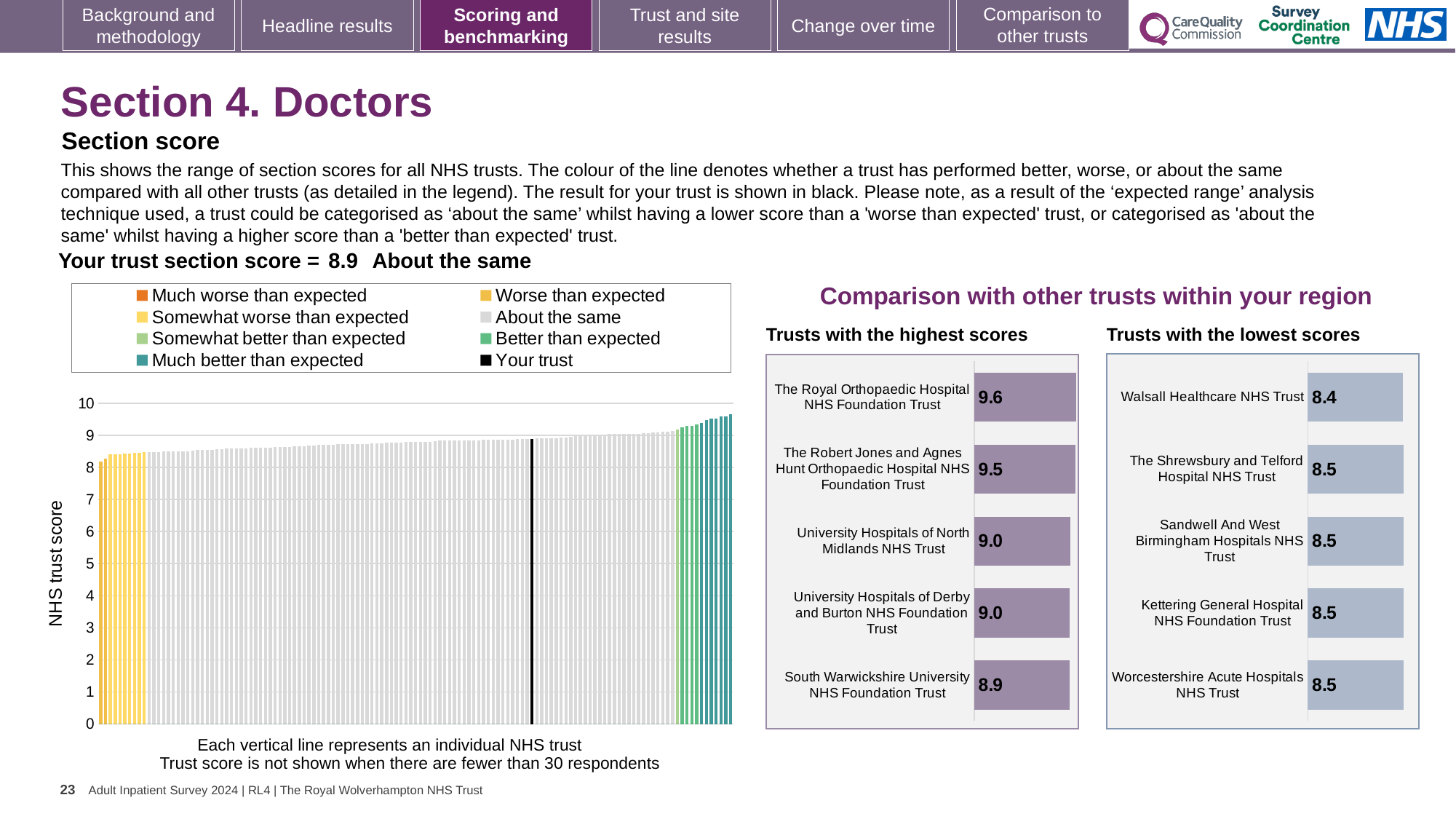
In the 'Trusts with the lowest scores' chart, what is the difference between the scores of Kettering General Hospital NHS Foundation Trust and Walsall Healthcare NHS Trust? 0.1 In the 'Trusts with the highest scores' chart, what is the score for South Warwickshire University NHS Foundation Trust? 8.9 In the NHS trust score chart on the left, do the values rise or fall from left to right along the x axis? Rise How many trusts are shown in the 'Trusts with the lowest scores' chart? 5 In the 'Trusts with the highest scores' chart, what is the difference between the scores of The Royal Orthopaedic Hospital NHS Foundation Trust and South Warwickshire University NHS Foundation Trust? 0.7 What kind of chart is the NHS trust score chart on the left? Bar chart In the 'Trusts with the highest scores' chart, which trust has the highest score? The Royal Orthopaedic Hospital NHS Foundation Trust In the 'Trusts with the highest scores' chart, what is the score for The Royal Orthopaedic Hospital NHS Foundation Trust? 9.6 In the 'Trusts with the lowest scores' chart, what is the score for Walsall Healthcare NHS Trust? 8.4 How many entries does the legend of the NHS trust score chart list? 8 In the 'Trusts with the lowest scores' chart, which trust has the lowest score? Walsall Healthcare NHS Trust In the 'Trusts with the highest scores' chart, which has the larger score: The Robert Jones and Agnes Hunt Orthopaedic Hospital NHS Foundation Trust or University Hospitals of North Midlands NHS Trust? The Robert Jones and Agnes Hunt Orthopaedic Hospital NHS Foundation Trust